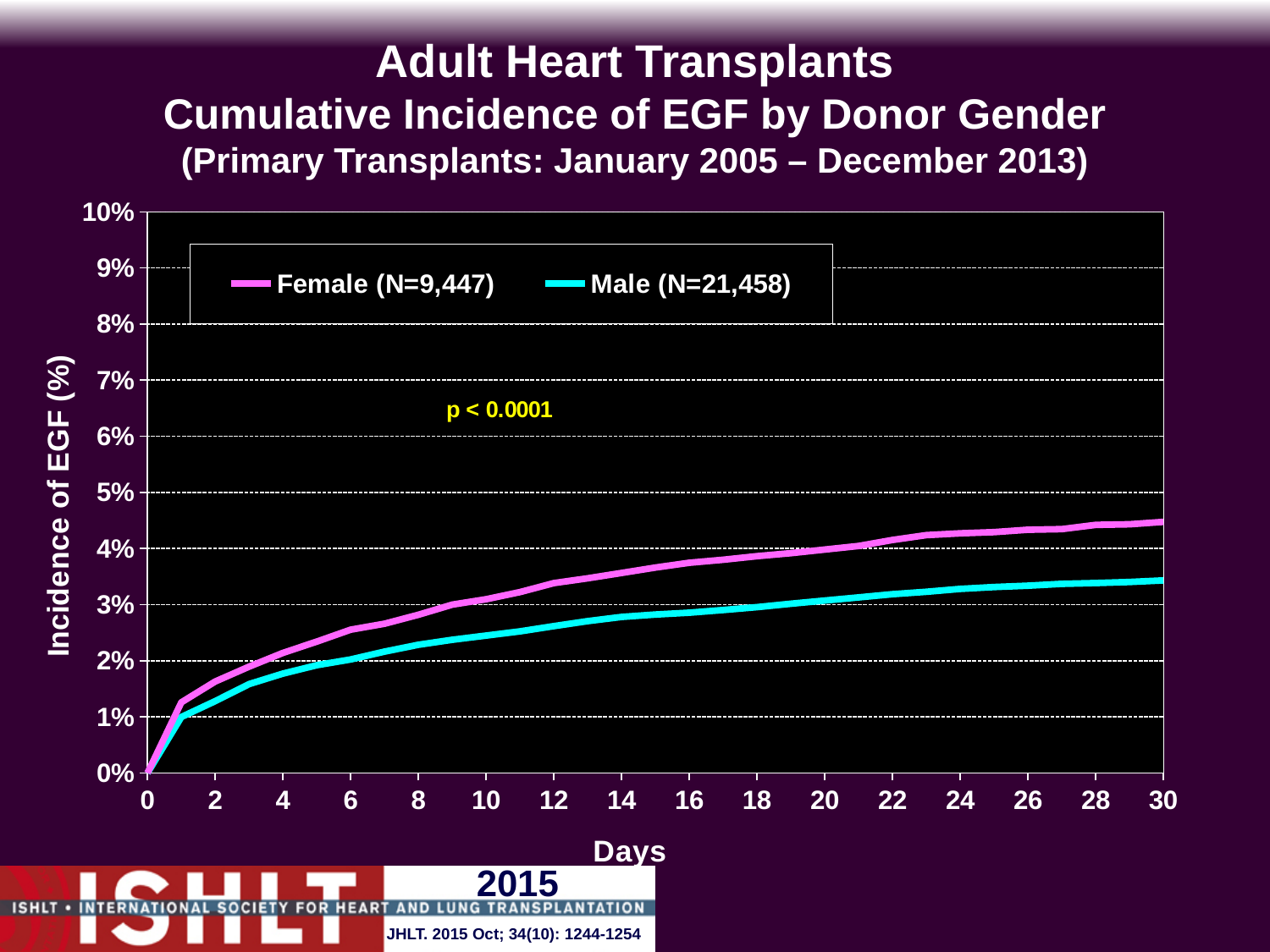
What p-value is printed on the chart? p < 0.0001 Is the value for the Male series at day 10 greater or less than 3%? less What is the highest value shown on the y axis? 10% What kind of chart is shown on the slide? line chart Do the values for the Male series rise or fall as days increase? rise Is the value for the Male series at day 30 greater or less than 4%? less Is the value for the Female series at day 14 greater or less than 3%? greater Do the values for the Female series rise or fall as days increase? rise How many series does the legend list? 2 At day 30, which series has the higher incidence of EGF, Female or Male? Female Which two series are shown in the legend? Female (N=9,447) and Male (N=21,458)